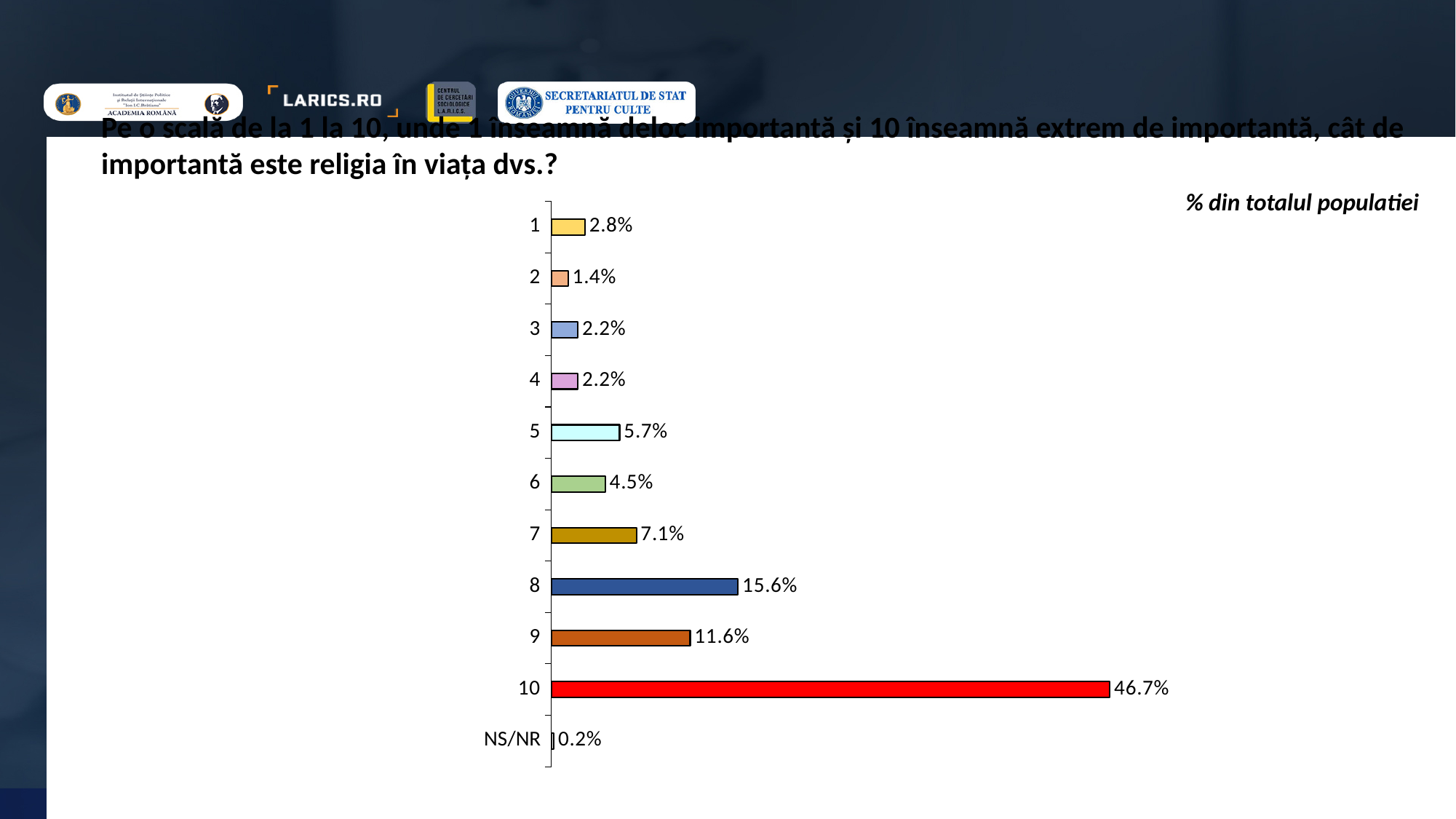
Which category has the lowest value? NS/NR What is the difference between the values for ratings 10 and 9? 35.1% What colour is the bar for rating 10? Red Which category has the highest value? 10 What is the value for the rating 5? 5.7% What kind of chart is shown on the slide? Bar chart What is the difference between the values for ratings 8 and 7? 8.5% What percentage is shown for NS/NR? 0.2% Which is larger, the value for rating 6 or the value for rating 7? 7 How many categories are shown on the chart? 11 What is the value shown for the rating 8? 15.6% What percentage of respondents rated the importance of religion as 10? 46.7%